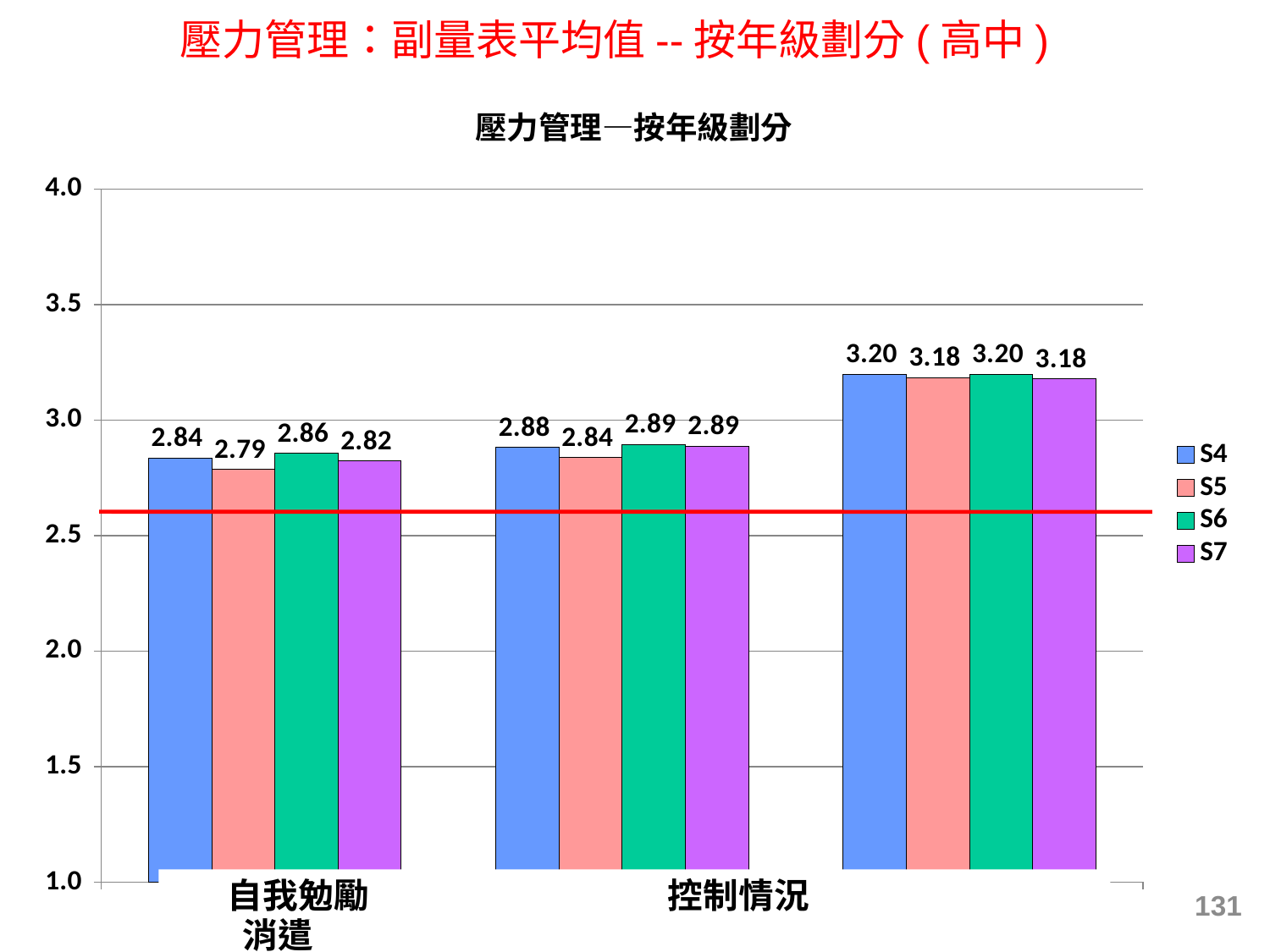
What kind of chart is shown on the slide? bar chart What is the value for S4 in the 控制情況 group? 2.88 What is the difference between the S4 value for 控制情況 and the S4 value for 自我勉勵消遣? 0.04 What is the value for S5 in the 自我勉勵消遣 group? 2.79 How many series does the legend list? 4 What is the value for S6 in the 控制情況 group? 2.89 What is the difference between the S6 and S5 values in the 自我勉勵消遣 group? 0.07 Is the S4 value larger for 自我勉勵消遣 or for 控制情況? 控制情況 Which series has the highest value in the 自我勉勵消遣 group? S6 Which series has the lowest value in the 自我勉勵消遣 group? S5 Which series has the lowest value in the 控制情況 group? S5 Is the value for S7 in the 自我勉勵消遣 group greater or less than 3.0? less